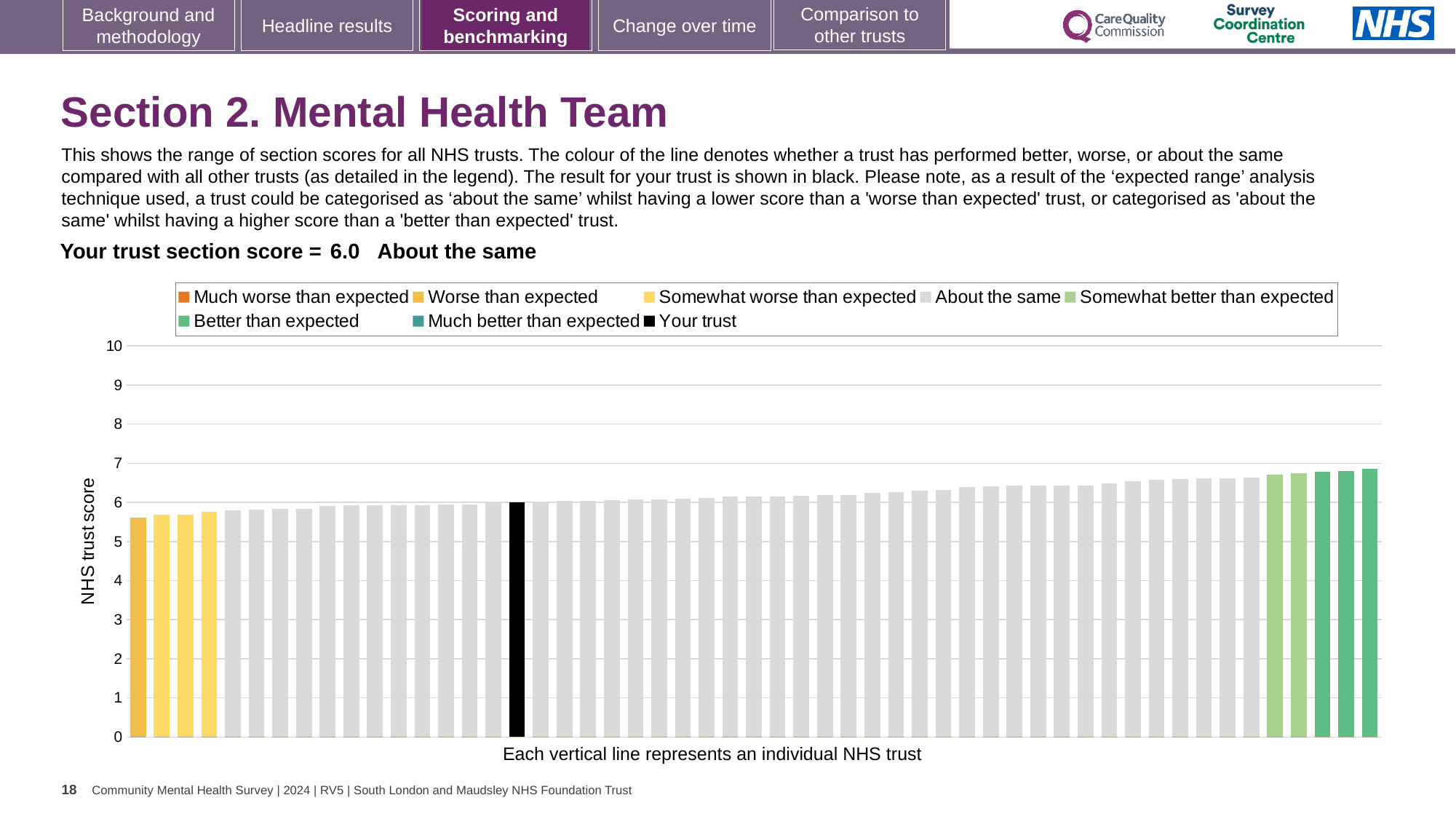
What is the section score for your trust shown on the slide? 6.0 Is the value of the black bar (your trust) greater or less than 5? greater Is the value of the black bar (your trust) greater or less than 7? less Do the bar values rise or fall from left to right along the x axis? rise What is the highest value shown on the vertical axis? 10 What kind of chart is shown on the slide? bar chart Is the value of the tallest bar in the chart greater or less than 7? less What is the label on the vertical axis of the chart? NHS trust score Which legend entry is shown in black? Your trust How many entries does the chart legend list? 8